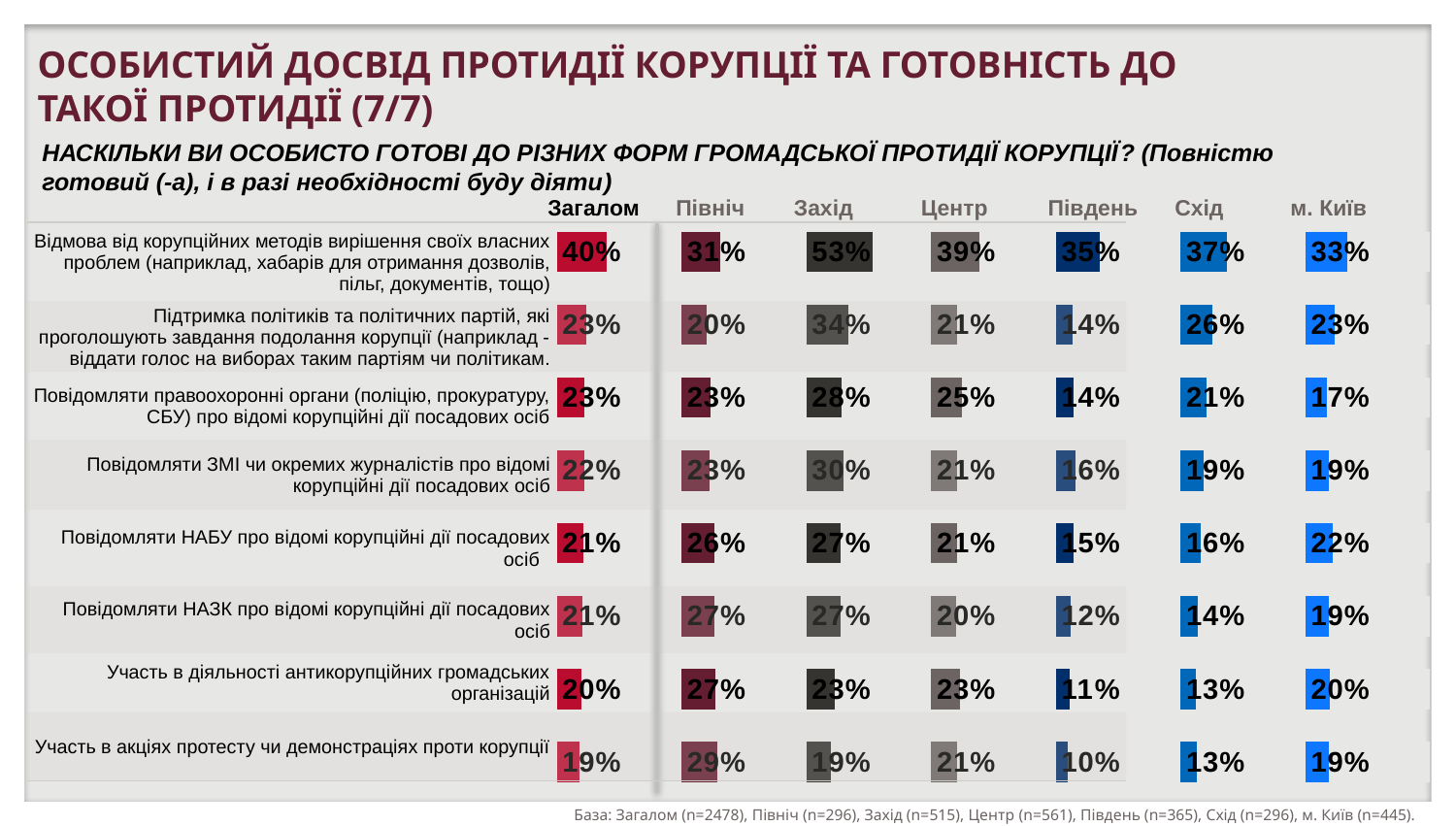
In the "Південь" chart, which category has the lowest value? Участь в акціях протесту чи демонстраціях проти корупції In the "Схід" chart, what is the value for "Повідомляти НАЗК про відомі корупційні дії посадових осіб"? 14% What type of chart is used for the "Центр" column? Bar chart How many categories are shown in the "Загалом" chart? 8 For "Участь в акціях протесту чи демонстраціях проти корупції", which is larger: the value in the "Північ" chart or the value in the "Схід" chart? Північ In the "м. Київ" chart, which category has the highest value? Відмова від корупційних методів вирішення своїх власних проблем In the "Захід" chart, what is the value for "Підтримка політиків та політичних партій, які проголошують завдання подолання корупції"? 34% How many regional charts (columns) are shown on the slide, including "Загалом"? 7 In the "Загалом" chart, do the values rise or fall from the top category to the bottom category? Fall In the "Південь" chart, what is the value for "Участь в акціях протесту чи демонстраціях проти корупції"? 10% In the "Захід" chart, what is the difference between "Відмова від корупційних методів вирішення своїх власних проблем" (53%) and "Повідомляти ЗМІ чи окремих журналістів про відомі корупційні дії посадових осіб" (30%)? 23% In the "Загалом" chart, what is the value for "Відмова від корупційних методів вирішення своїх власних проблем"? 40%